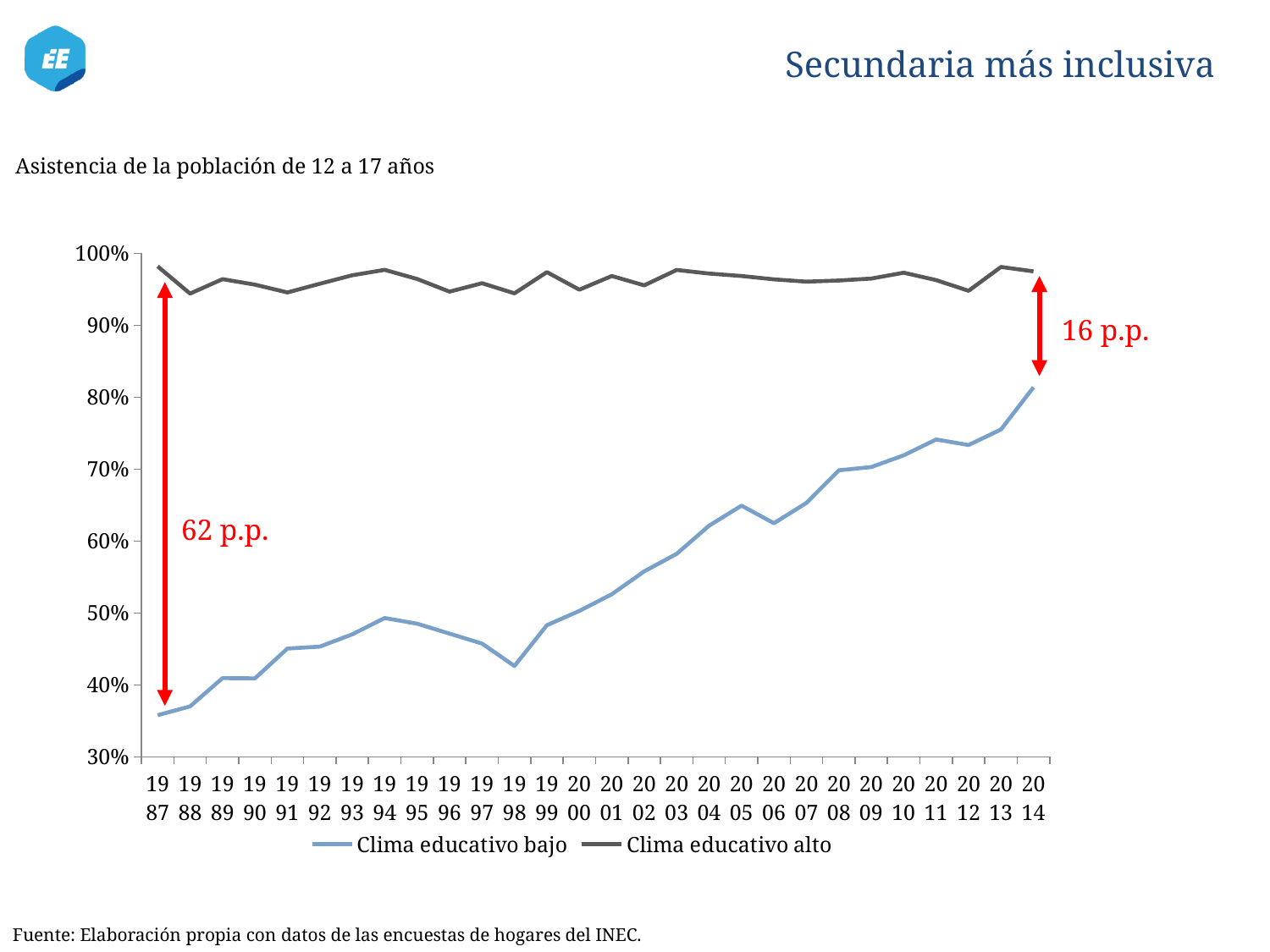
How many series does the legend list? 2 What is the subtitle describing the chart's data? Asistencia de la población de 12 a 17 años Which series has the larger value in 2005, 'Clima educativo bajo' or 'Clima educativo alto'? Clima educativo alto What kind of chart is shown on the slide? line chart What is the gap in percentage points between the two series in 2014, as annotated on the chart? 16 p.p. Is the value for 'Clima educativo bajo' in 1987 greater or less than 40%? less What is the gap in percentage points between the two series in 1987, as annotated on the chart? 62 p.p. How many years are plotted along the x axis? 28 In which year is the 'Clima educativo bajo' value highest? 2014 What are the two series named in the legend? Clima educativo bajo, Clima educativo alto Does the 'Clima educativo bajo' line rise or fall from 1987 to 2014? rise In which year is the 'Clima educativo bajo' value lowest? 1987